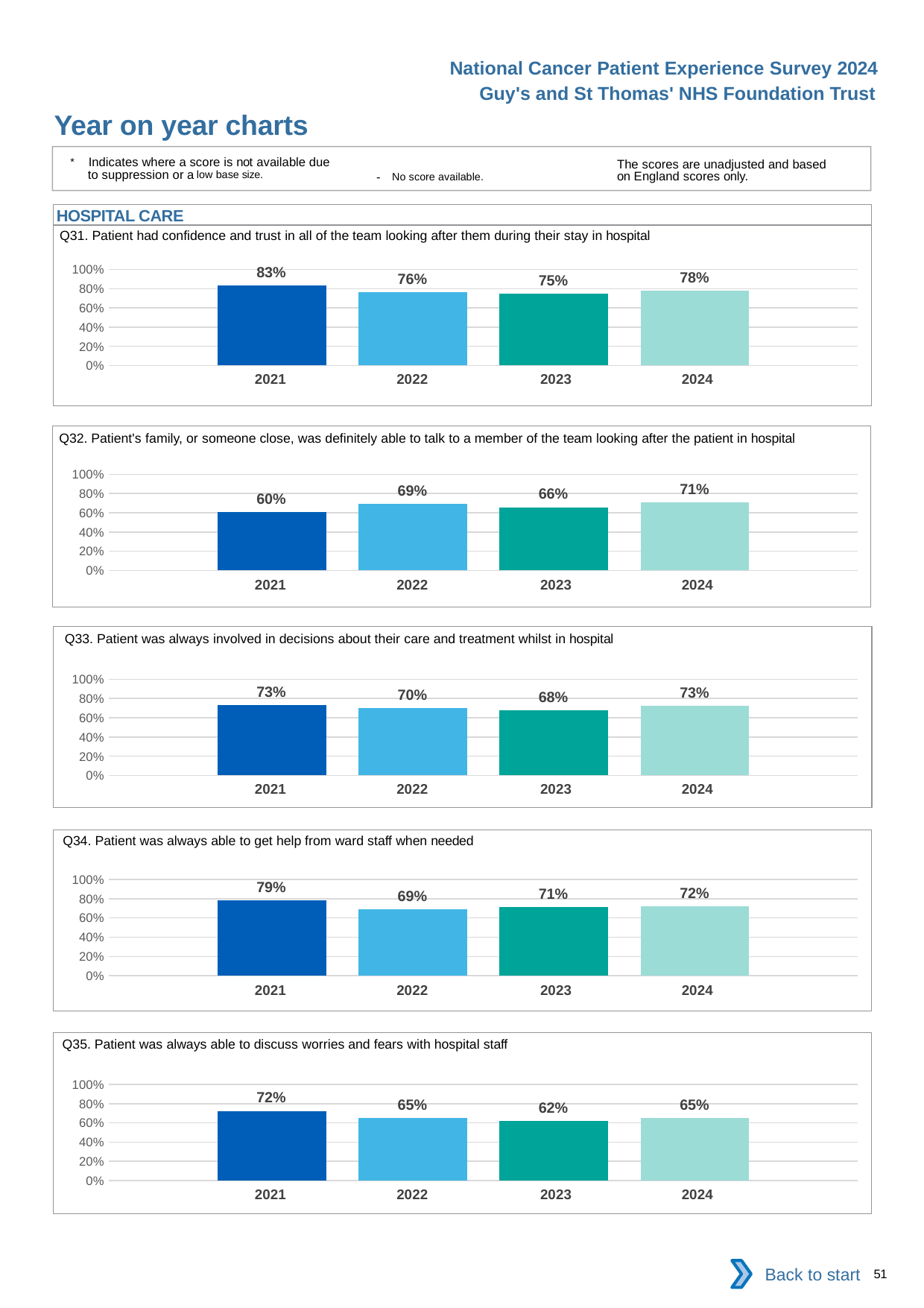
In the Q31 chart, is the value for 2023 greater or less than 60%? greater In the Q34 chart, which is larger, the value for 2021 or the value for 2024? 2021 In the Q35 chart, what is the value for 2023? 62% How many years are shown on the x axis of the Q31 chart? 4 How many charts are shown on the slide? 5 In the Q32 chart, which year has the highest value? 2024 In the Q31 chart, what is the value for 2021? 83% In the Q35 chart, which year has the highest value? 2021 In the Q34 chart, what is the difference between the 2021 and 2022 values? 10 percentage points What kind of chart is the Q34 chart? Bar chart In the Q33 chart, what is the difference between the 2021 and 2023 values? 5 percentage points In the Q32 chart, which year has the lowest value? 2021